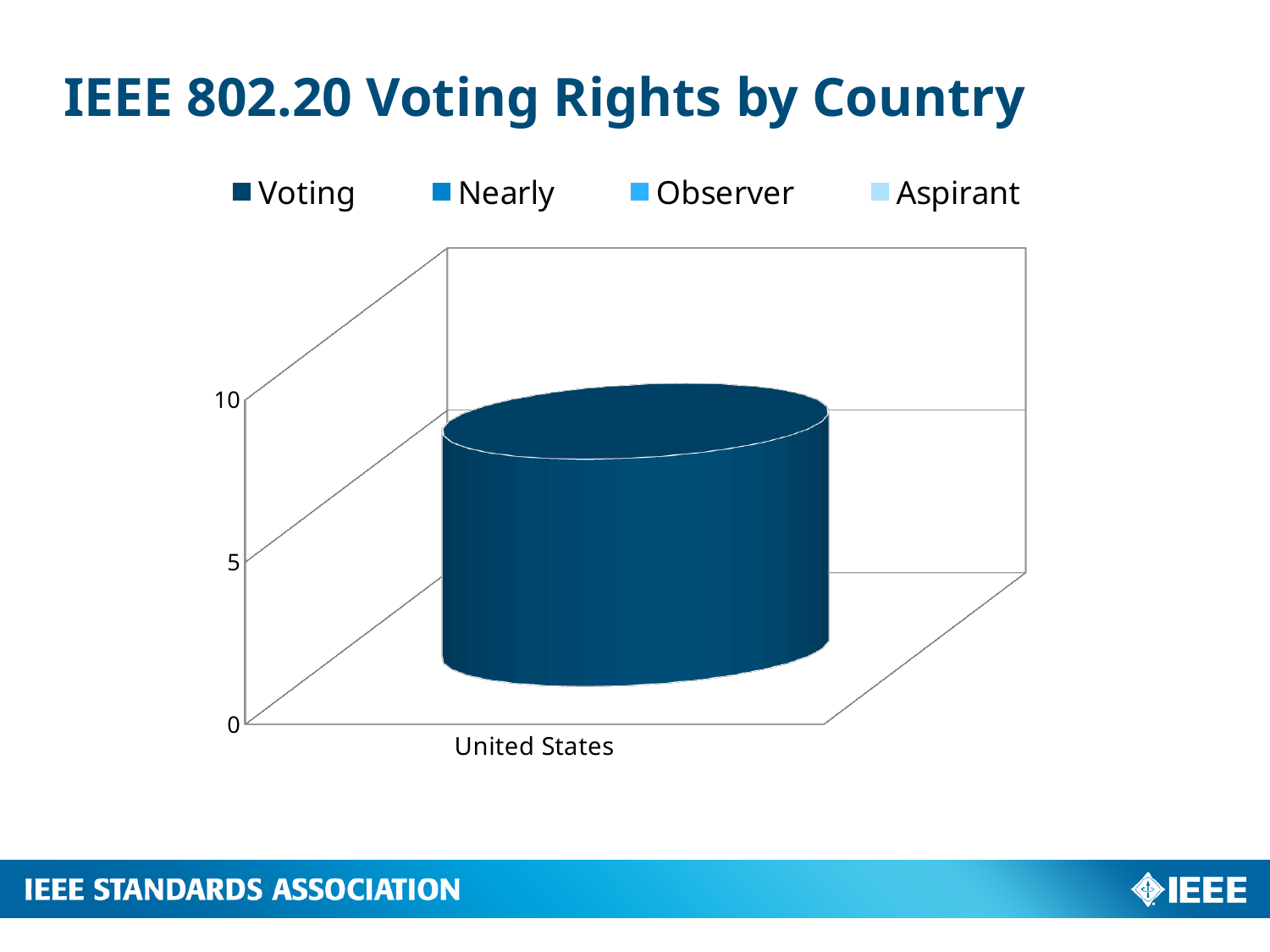
Which country is shown on the x axis of the chart? United States What are the four series listed in the chart legend? Voting, Nearly, Observer, Aspirant How many series does the chart legend list? 4 Is the Voting value for United States greater or less than 5? greater How many countries are shown on the x axis of the chart? 1 What is the highest value labelled on the vertical axis of the chart? 10 What kind of chart is shown on the slide? bar chart What is the title of the chart on the slide? IEEE 802.20 Voting Rights by Country